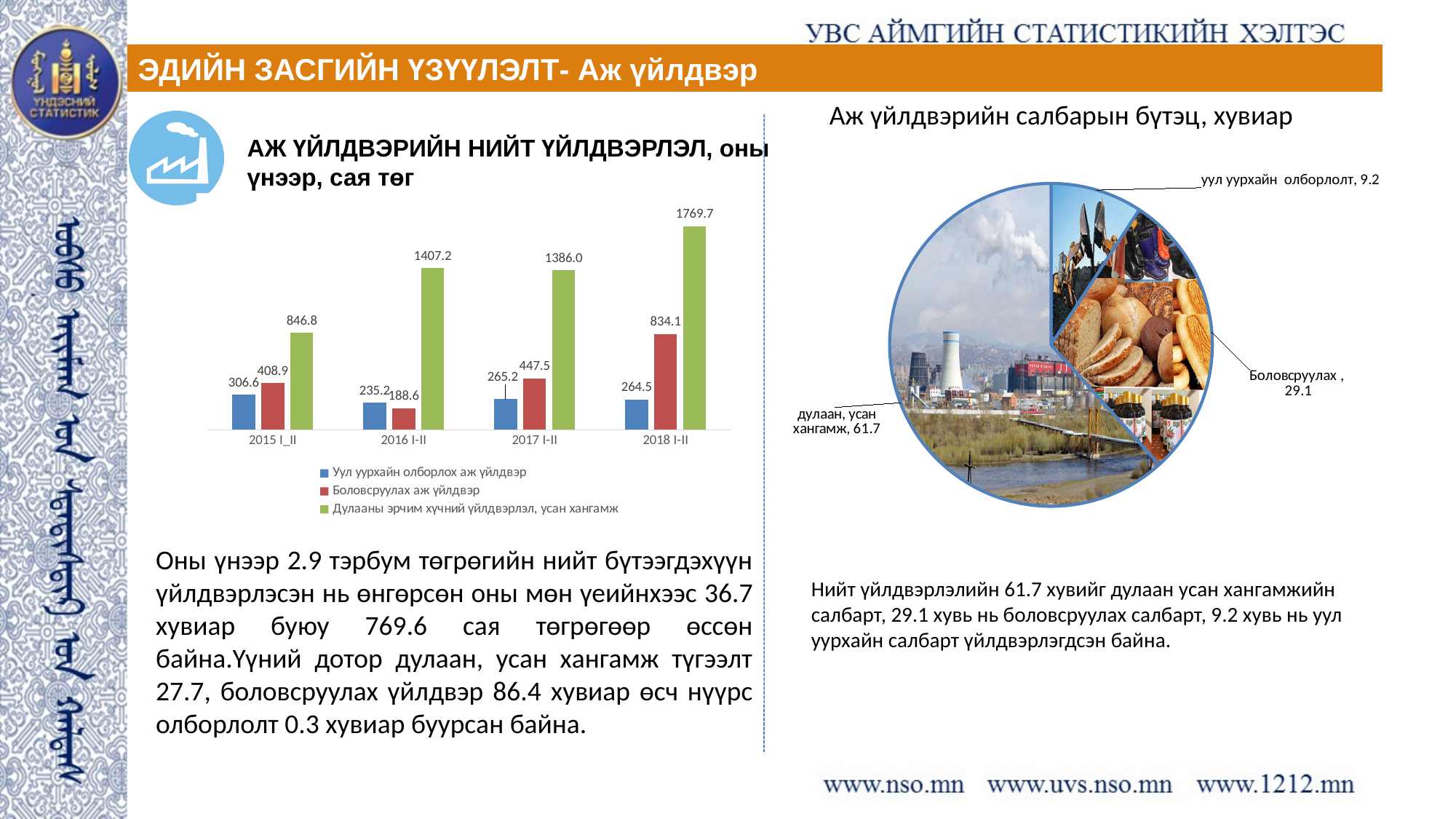
In the bar chart on the left, which period has the highest value for Боловсруулах аж үйлдвэр? 2018 I-II In the bar chart on the left, what is the value for Дулааны эрчим хүчний үйлдвэрлэл, усан хангамж in 2018 I-II? 1769.7 In the bar chart on the left, what is the value for Уул уурхайн олборлох аж үйлдвэр in 2015 I_II? 306.6 In the pie chart 'Аж үйлдвэрийн салбарын бүтэц, хувиар', which sector has the smallest share? уул уурхайн олборлолт In the bar chart on the left, which period has the lowest value for Уул уурхайн олборлох аж үйлдвэр? 2016 I-II How many series does the legend of the bar chart on the left list? 3 In the pie chart 'Аж үйлдвэрийн салбарын бүтэц, хувиар', what is the share for Боловсруулах? 29.1 In the bar chart on the left, which is larger in 2017 I-II: Уул уурхайн олборлох аж үйлдвэр or Боловсруулах аж үйлдвэр? Боловсруулах аж үйлдвэр How many periods are shown on the x axis of the bar chart on the left? 4 In the bar chart on the left, what is the value for Боловсруулах аж үйлдвэр in 2016 I-II? 188.6 In the bar chart on the left, what is the difference between the Боловсруулах аж үйлдвэр values for 2018 I-II and 2017 I-II? 386.6 What kind of chart is the chart titled 'Аж үйлдвэрийн салбарын бүтэц, хувиар'? pie chart